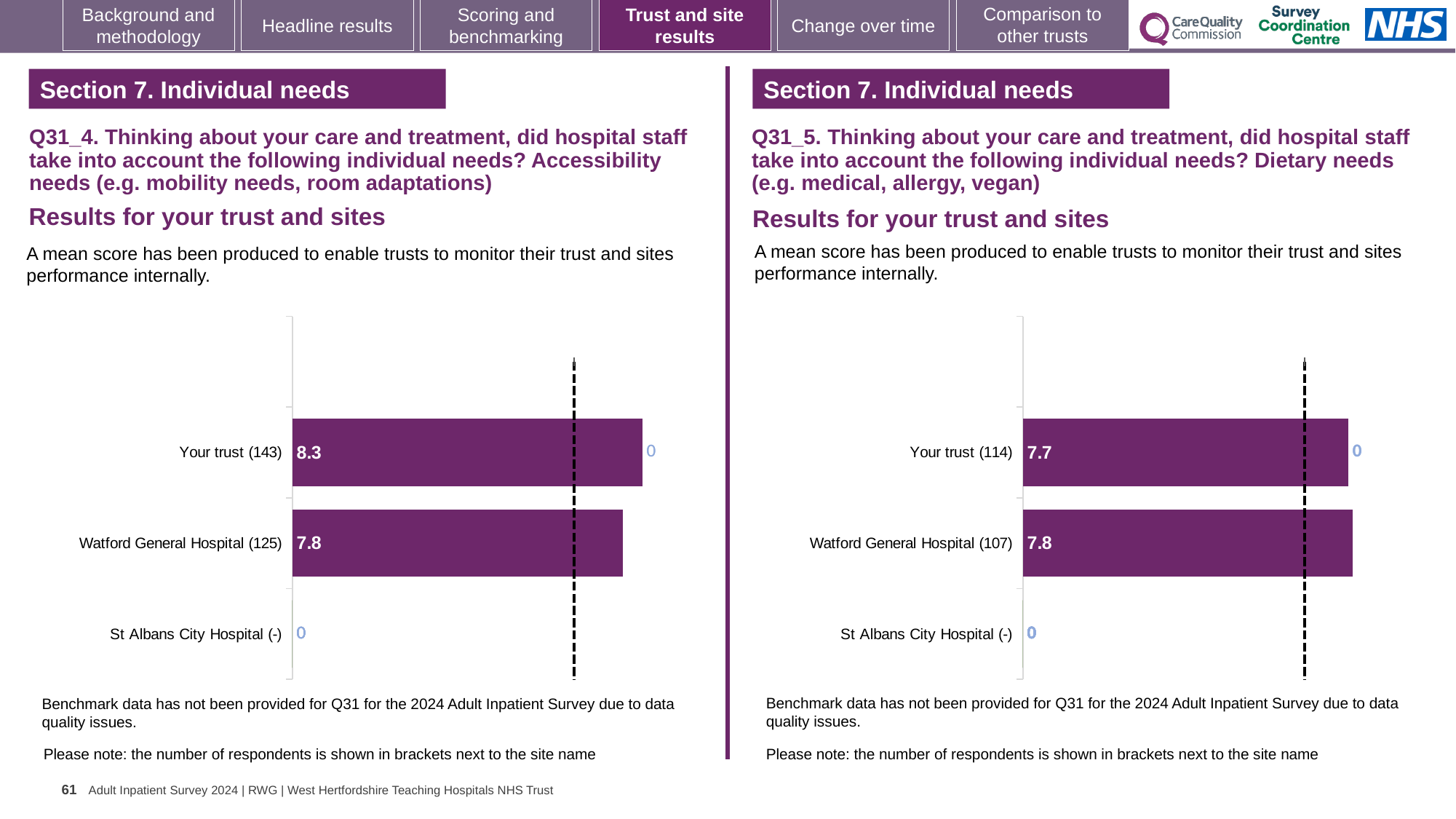
On the right chart (Q31_5, dietary needs), how many respondents are shown in brackets for Your trust? 114 On the left chart (Q31_4, accessibility needs), how many respondents are shown in brackets for Watford General Hospital? 125 On the left chart (Q31_4, accessibility needs), what is the mean score for Your trust (143)? 8.3 On the left chart (Q31_4, accessibility needs), what is the difference between the scores for Your trust and Watford General Hospital? 0.5 On the right chart (Q31_5, dietary needs), what is the mean score for Watford General Hospital (107)? 7.8 How many site/trust categories are listed on the left chart (Q31_4, accessibility needs)? 3 On the right chart (Q31_5, dietary needs), which has the higher score: Your trust or Watford General Hospital? Watford General Hospital On the right chart (Q31_5, dietary needs), what is the mean score for Your trust (114)? 7.7 On the left chart (Q31_4, accessibility needs), what is the mean score for Watford General Hospital (125)? 7.8 On the left chart (Q31_4, accessibility needs), which has the higher score: Your trust or Watford General Hospital? Your trust On the right chart (Q31_5, dietary needs), what is the difference between the scores for Watford General Hospital and Your trust? 0.1 What kind of chart is used on the right side of the slide (Q31_5, dietary needs)? Bar chart